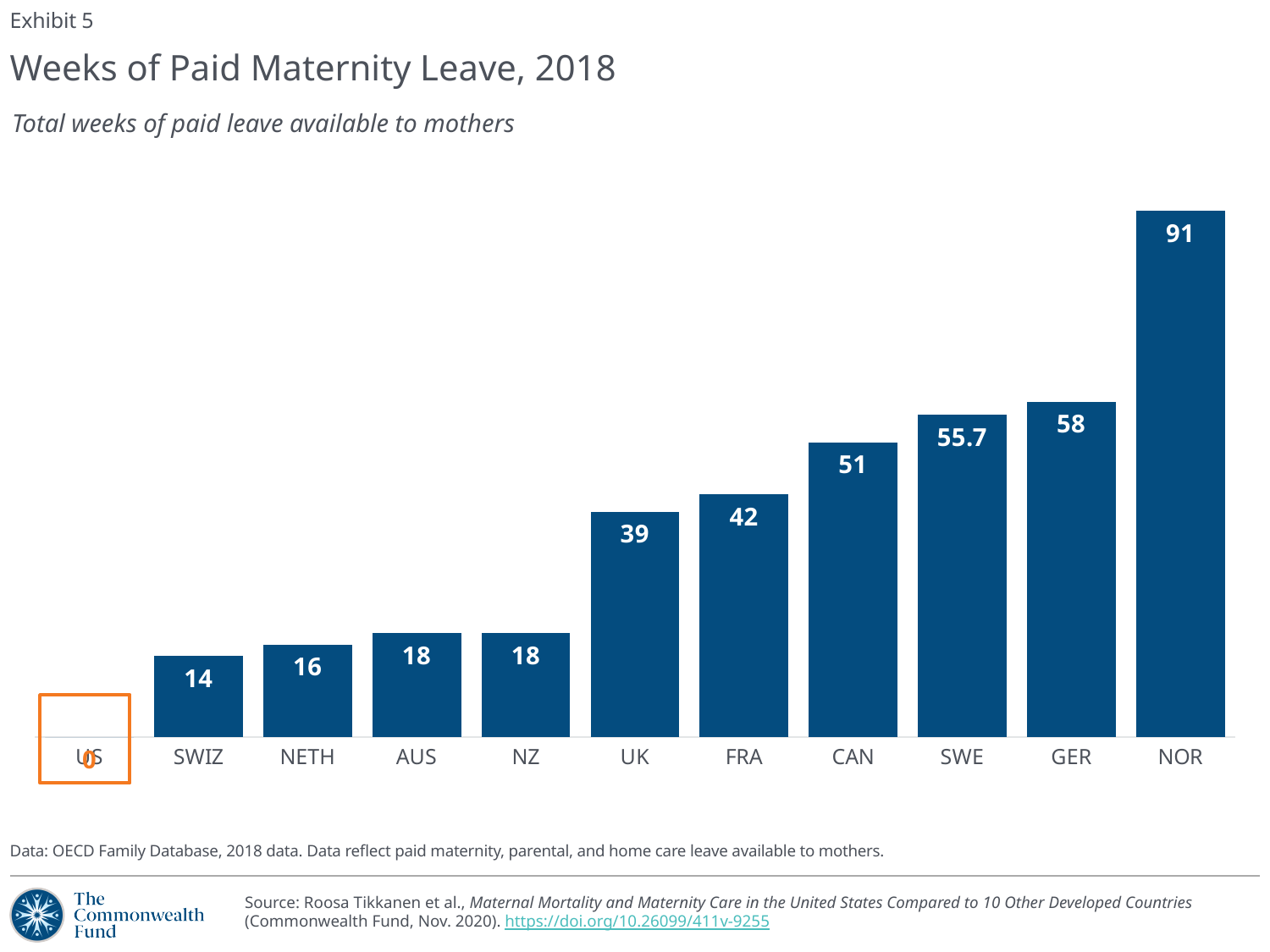
What is the difference between the values for NOR and GER? 33 What kind of chart is this? bar chart What is the value for the US? 0 What is the value for NOR? 91 Which country has the lowest number of weeks of paid maternity leave? US What is the value for SWE? 55.7 Which is larger, the value for CAN or the value for FRA? CAN How many countries are shown in the chart? 11 Do the values rise or fall from left to right along the x axis? rise What is the title of the chart? Weeks of Paid Maternity Leave, 2018 What is the difference between the values for UK and SWIZ? 25 Which country has the highest number of weeks of paid maternity leave? NOR